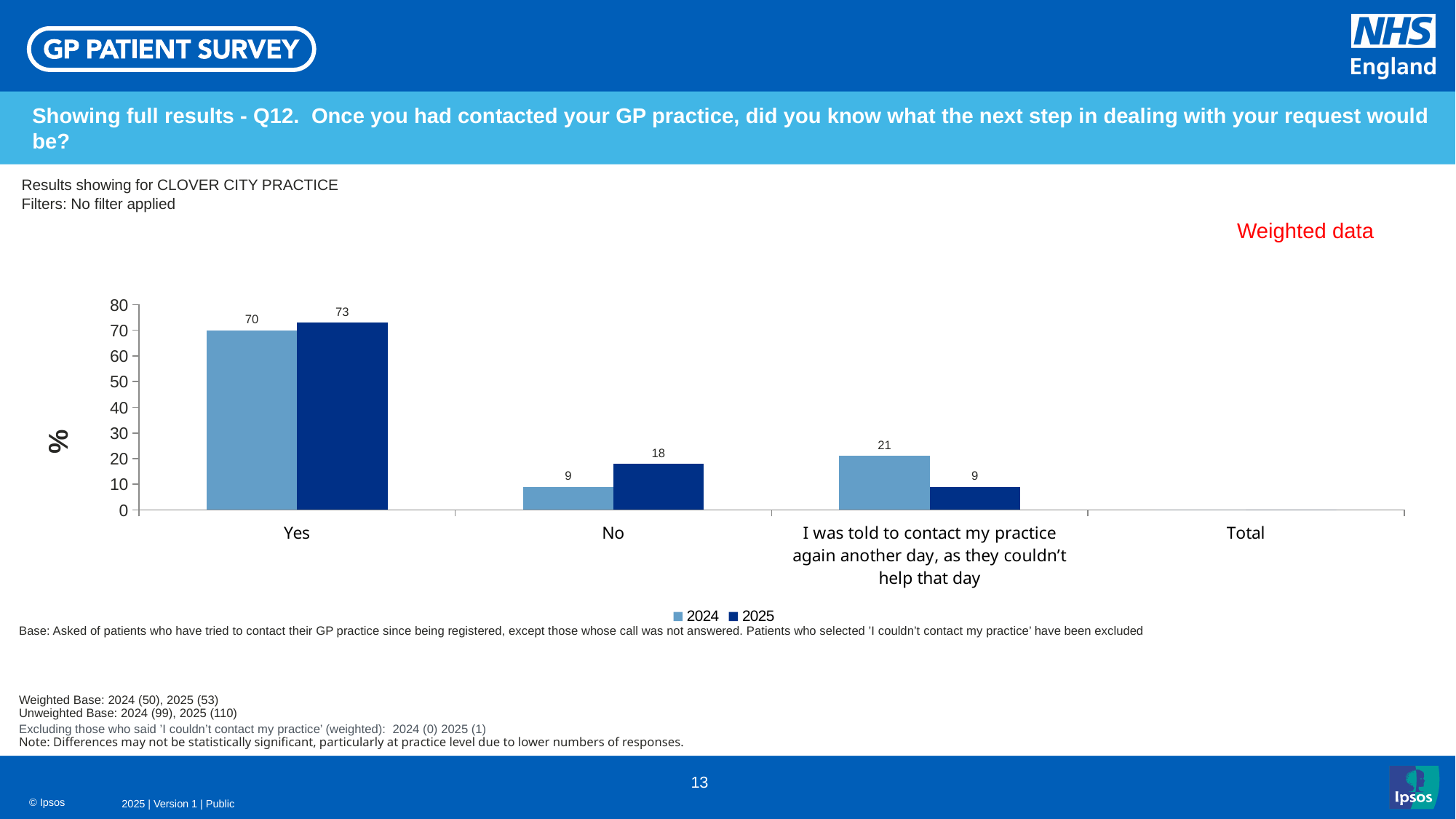
Which category has the lowest value in the 2024 series? No What is the 2025 value for 'Yes'? 73 What is the difference between the 2024 and 2025 values for 'I was told to contact my practice again another day, as they couldn't help that day'? 12 What is the 2024 value for 'No'? 9 How many series does the legend list? 2 Which category has the highest value in the 2025 series? Yes Is the 2024 value for 'Yes' greater or less than 60? greater What is the difference between the 2025 and 2024 values for 'Yes'? 3 Which is larger for 'No': the 2024 value or the 2025 value? 2025 What kind of chart is shown on the slide? Bar chart What label is shown on the vertical axis? % What is the 2024 value for 'I was told to contact my practice again another day, as they couldn't help that day'? 21